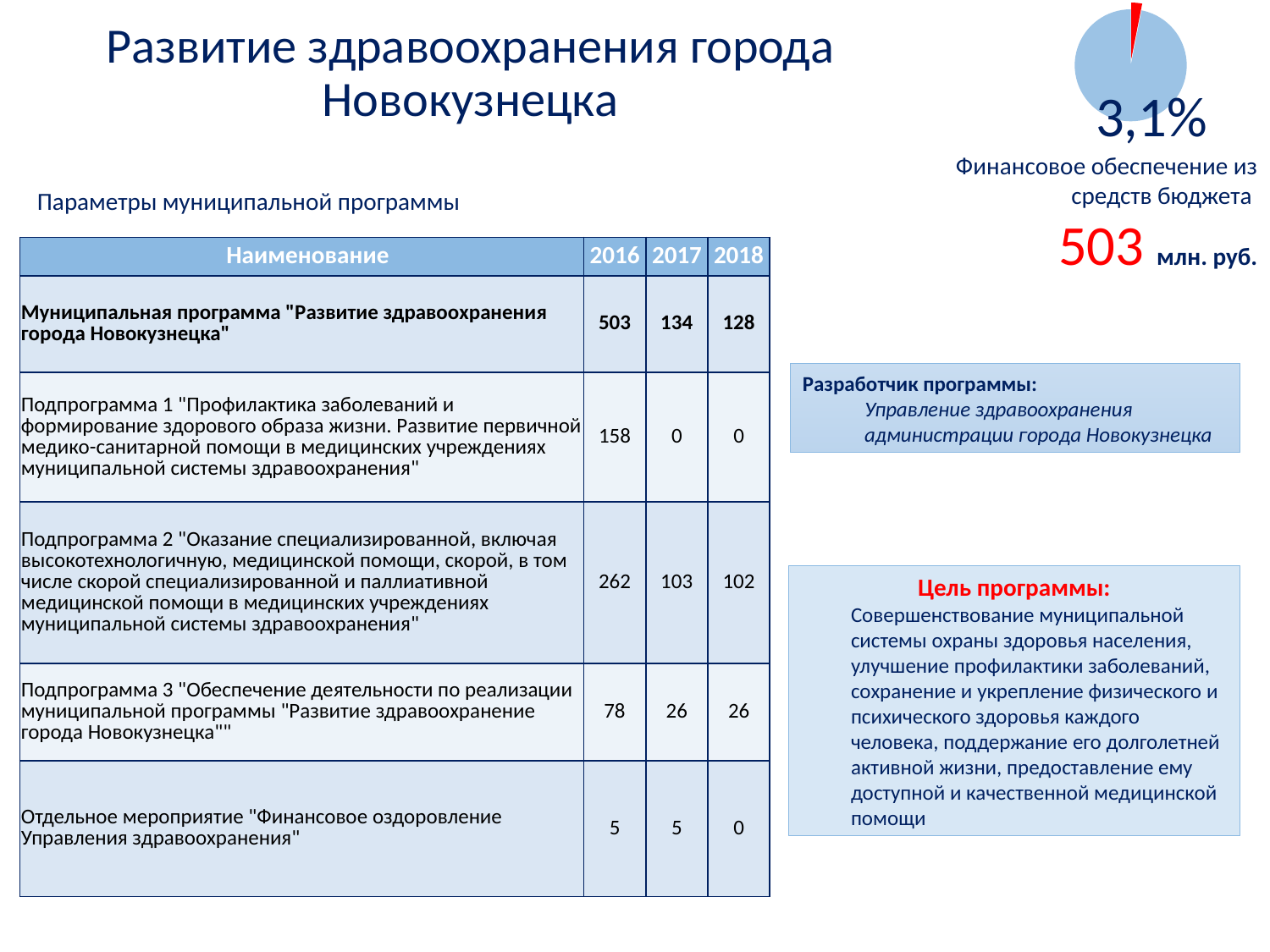
What colour is the small slice of the pie chart that is labelled 3,1%? red How many slices does the pie chart in the top right corner have? 2 Which slice of the pie chart is larger, the red slice or the light blue slice? the light blue slice What kind of chart is shown in the top right corner of the slide? pie chart Is the share shown by the red slice of the pie chart greater or less than 50%? less What share of the budget does the highlighted red slice of the pie chart represent? 3,1% What colour is the large remaining slice of the pie chart? light blue